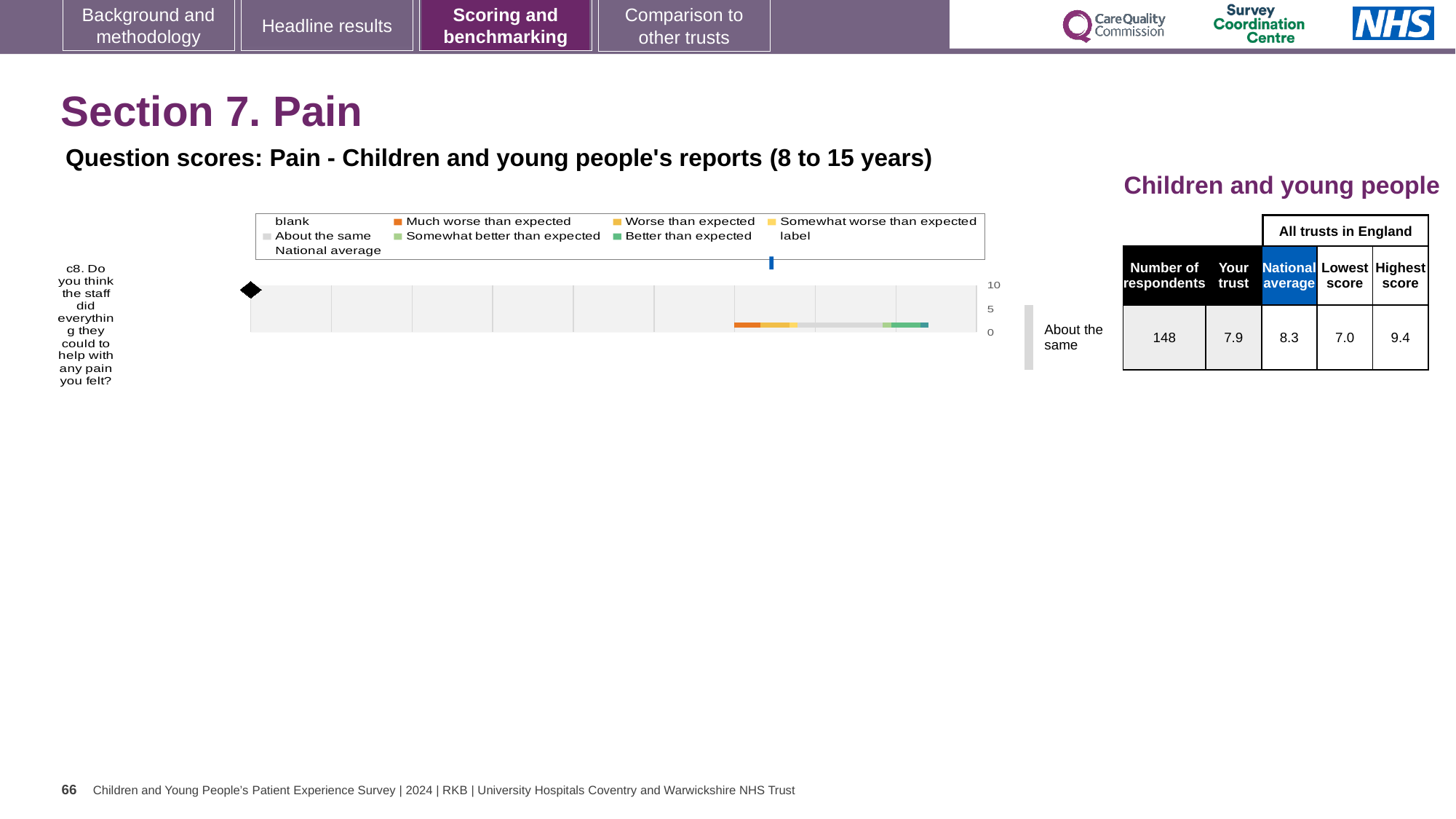
What is the lowest score among all trusts in England for question c8? 7.0 What is the difference between the highest and lowest scores for question c8? 2.4 What is the maximum value shown on the score axis of the chart? 10 What kind of chart is used to show the question score for c8? bar chart What is the difference between the national average and the trust's score for question c8? 0.4 What is the trust's score for question c8 (Do you think the staff did everything they could to help with any pain you felt)? 7.9 How many respondents answered question c8? 148 Which is larger for question c8: the trust's score or the national average? National average How many survey questions are plotted in the chart? 1 What benchmark category is the trust's score for question c8 placed in? About the same What is the national average score for question c8? 8.3 What is the highest score among all trusts in England for question c8? 9.4